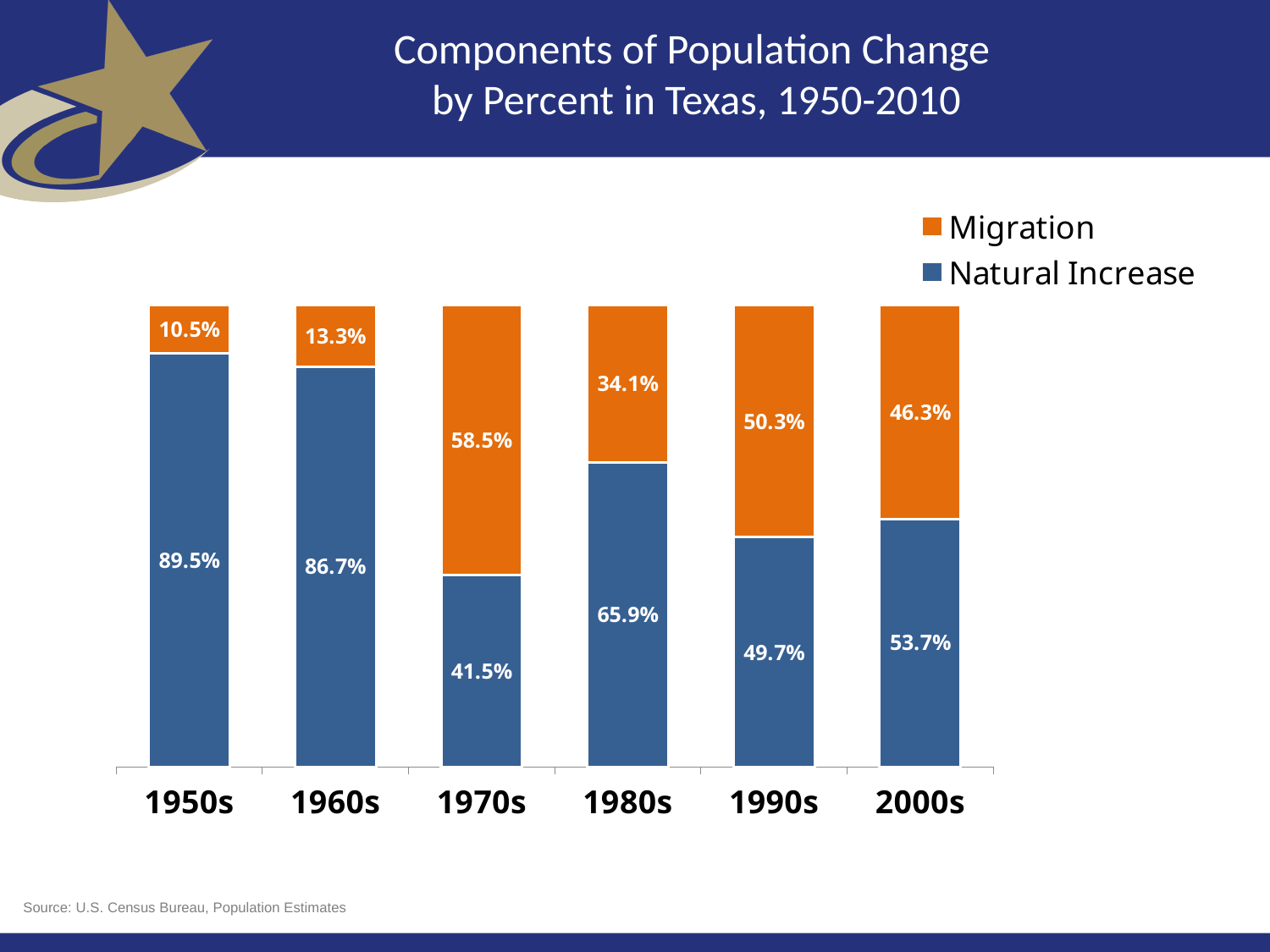
What is the Migration value for the 2000s? 46.3% What is the difference between the Natural Increase values for the 1950s and the 1960s? 2.8% What is the total of the stacked bar for the 1990s? 100% What is the Migration value for the 1970s? 58.5% What is the Natural Increase value for the 1950s? 89.5% How many series does the legend list? 2 Which decade has the highest Migration value? 1970s Which is larger in the 1980s, Migration or Natural Increase? Natural Increase Which colour represents Migration in the chart? Orange What kind of chart is shown on the slide? Stacked bar chart How many decades are shown on the x axis? 6 Which decade has the lowest Natural Increase value? 1970s